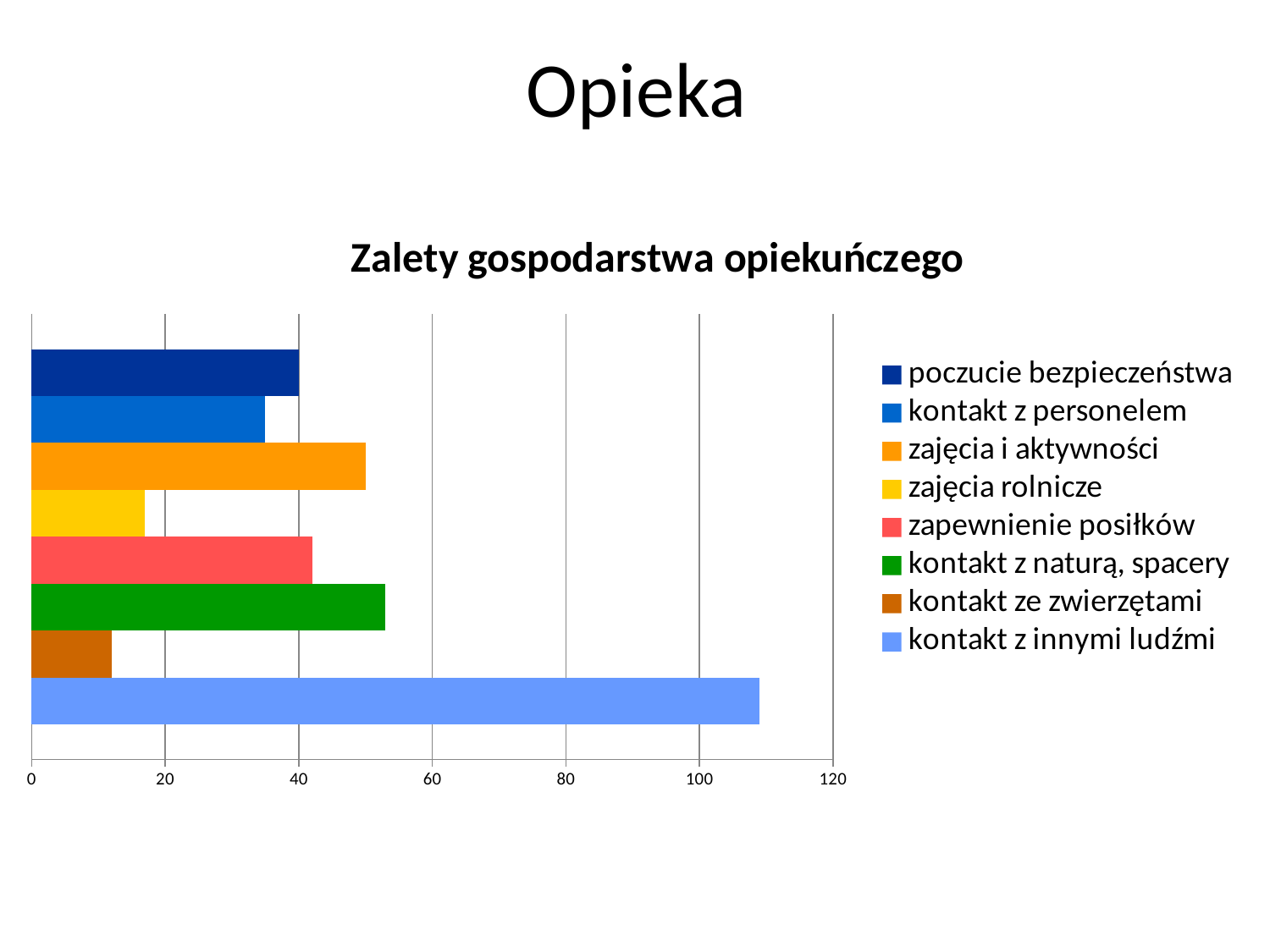
Is the value for zajęcia i aktywności greater or less than 40? greater Which is larger: the value for kontakt z naturą, spacery or the value for zajęcia rolnicze? kontakt z naturą, spacery Is the value for kontakt ze zwierzętami greater or less than 20? less What type of chart is shown on the slide? bar chart How many categories are plotted in the chart? 8 Which is larger: the value for zapewnienie posiłków or the value for kontakt ze zwierzętami? zapewnienie posiłków Which category has the lowest value? kontakt ze zwierzętami Is the value for kontakt z personelem greater or less than 40? less Which category has the highest value? kontakt z innymi ludźmi What is the title of the chart? Zalety gospodarstwa opiekuńczego